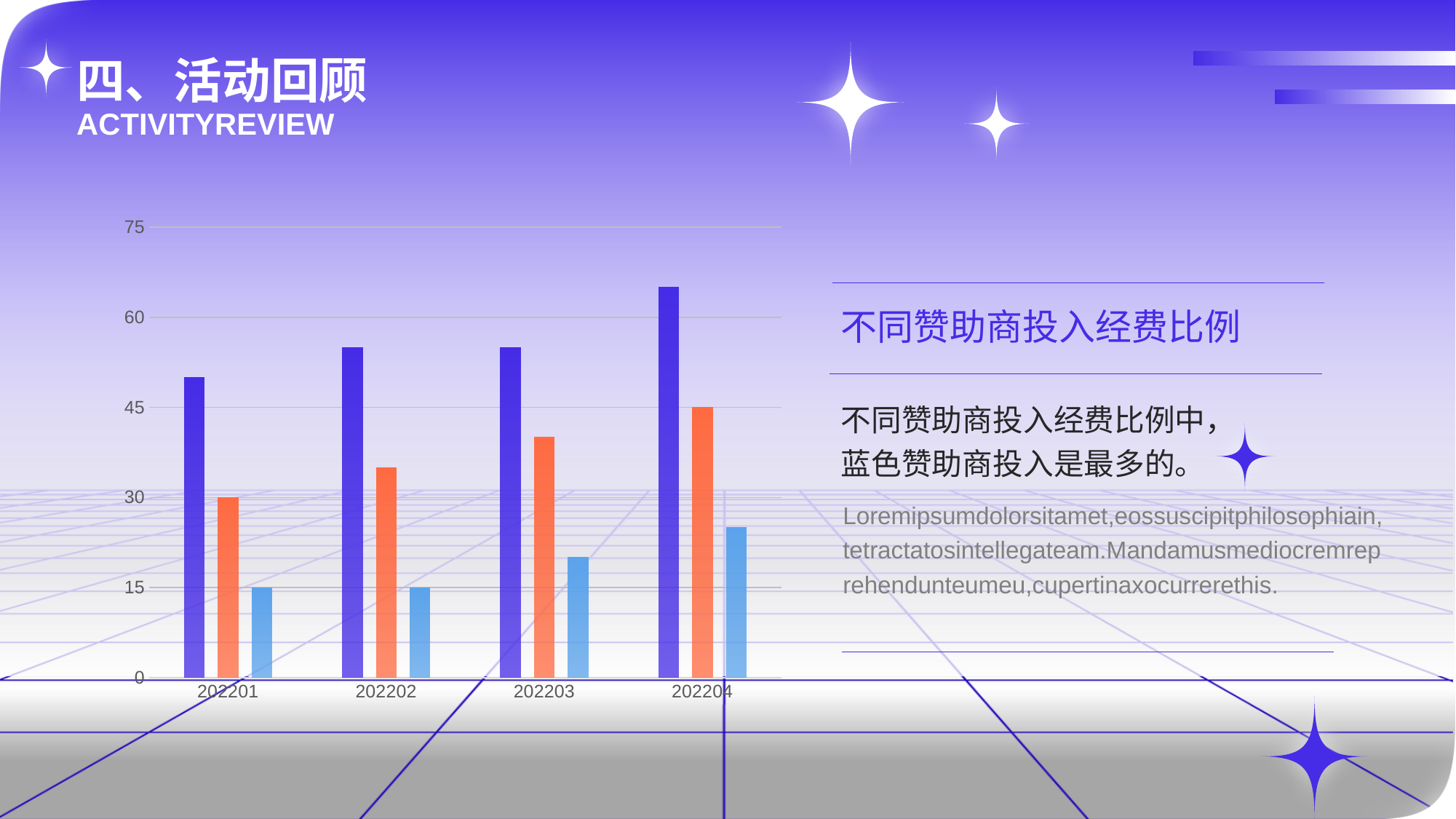
Which is larger for 202203, the purple bar or the orange bar? the purple bar Is the value of the purple bar for 202201 greater or less than 45? greater How many bars are plotted for each category in the chart? 3 Is the value of the purple bar for 202204 greater or less than 60? greater How many categories are shown on the x axis of the chart? 4 What is the value of the light blue bar for 202201? 15 What kind of chart is shown on the slide? bar chart Which category has the tallest purple bar? 202204 Do the orange bars rise or fall from 202201 to 202204? rise What is the value of the orange bar for 202204? 45 Is the value of the light blue bar for 202204 greater or less than 30? less What is the value of the orange bar for 202201? 30